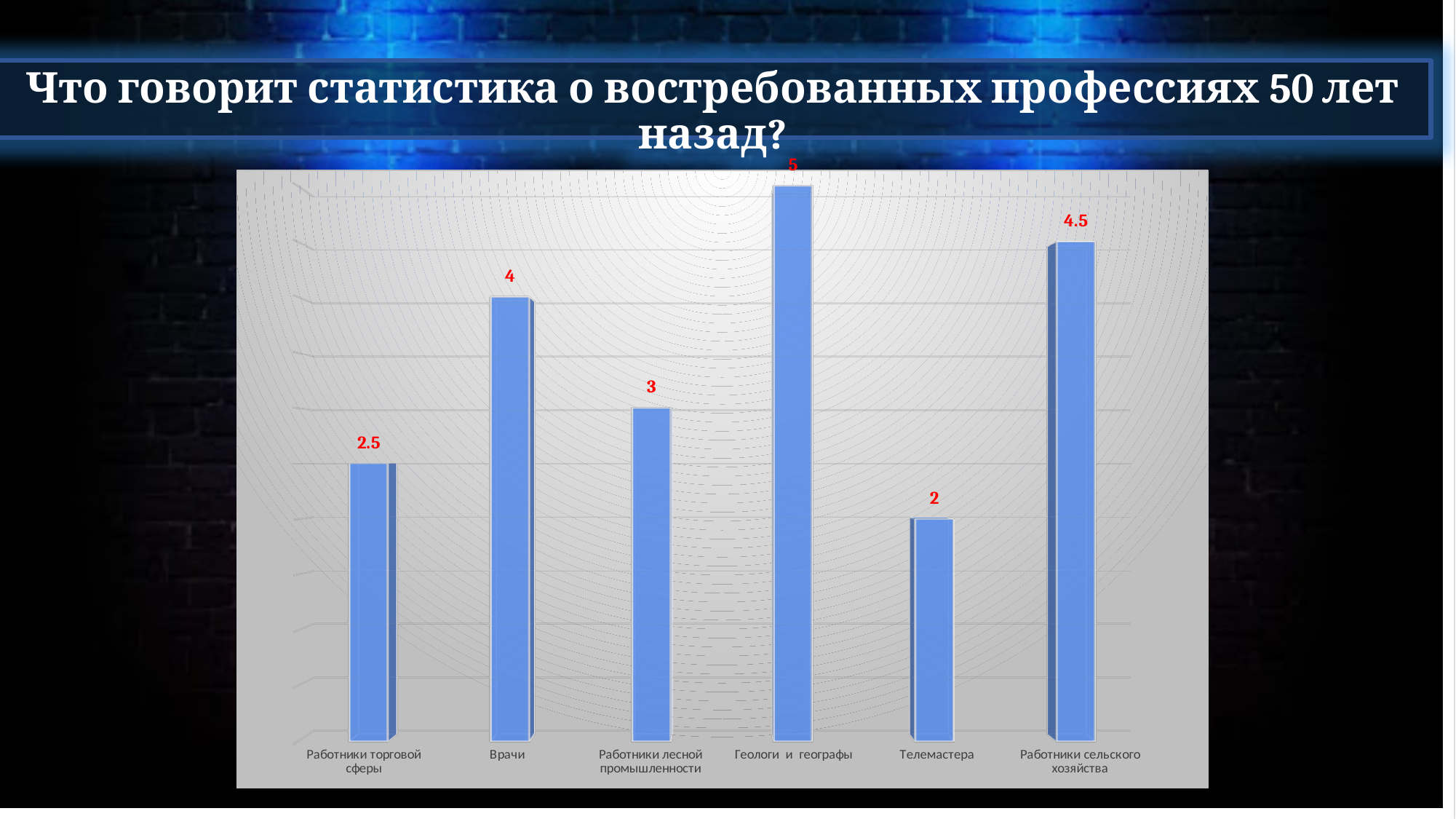
What is the value for Работники сельского хозяйства? 4.5 Which category has the lowest value? Телемастера What is the difference between the values for Работники сельского хозяйства and Работники лесной промышленности? 1.5 What is the value for Работники торговой сферы? 2.5 Which category has the highest value? Геологи и географы What kind of chart is shown on the slide? Bar chart What is the value for Врачи? 4 How many categories are shown in the chart? 6 Which is larger, the value for Врачи or the value for Работники лесной промышленности? Врачи What is the title of the slide containing the chart? Что говорит статистика о востребованных профессиях 50 лет назад? What is the difference between the values for Геологи и географы and Телемастера? 3 What is the value for Телемастера? 2